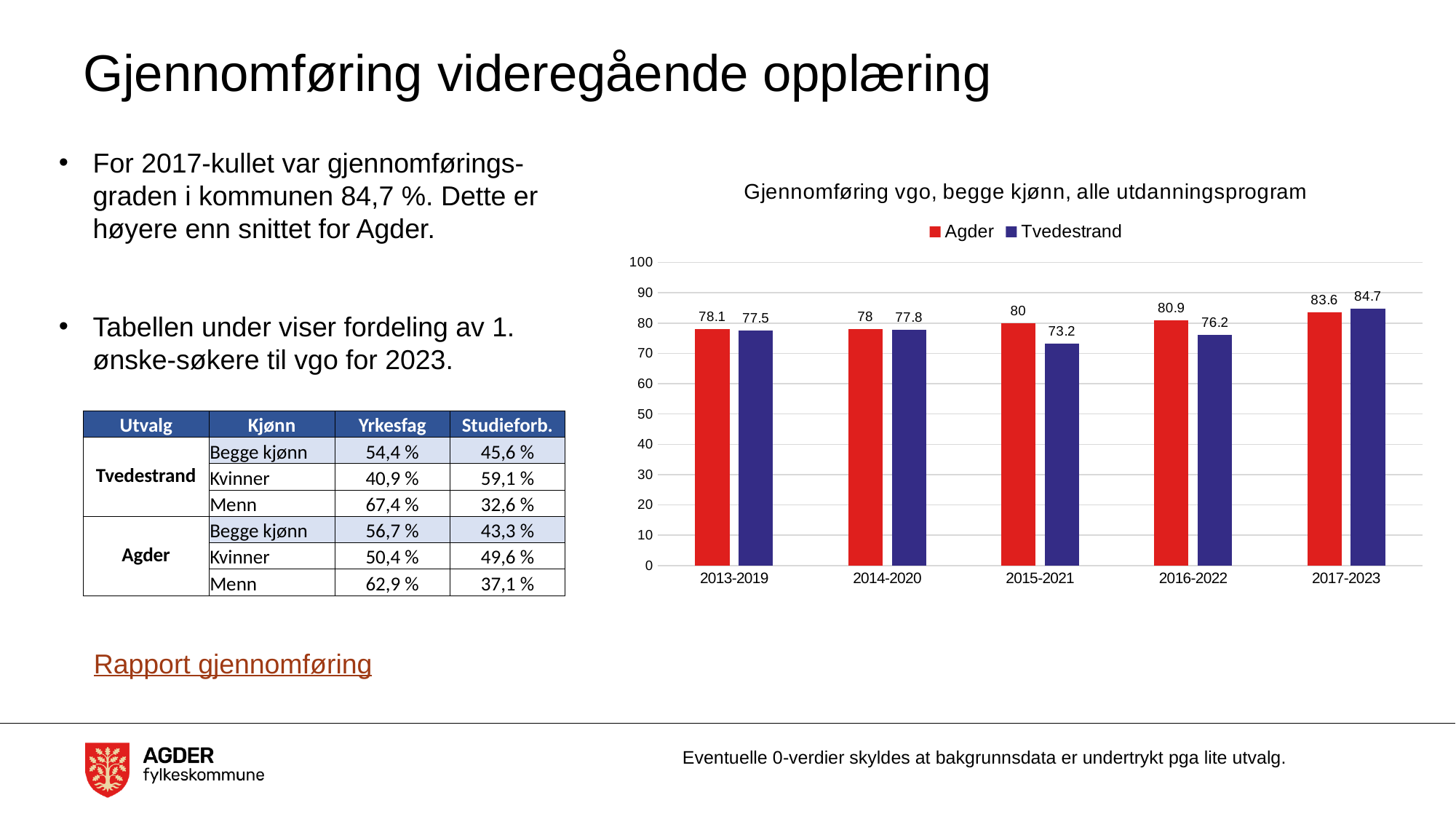
What is the title of the chart? Gjennomføring vgo, begge kjønn, alle utdanningsprogram Is the value for Tvedestrand in 2014-2020 greater or less than 70? greater Which period has the lowest value for Tvedestrand? 2015-2021 What is the value for Tvedestrand in 2015-2021? 73.2 What is the difference between Agder and Tvedestrand in 2015-2021? 6.8 What is the value for Agder in 2015-2021? 80 What kind of chart is shown? bar chart What is the value for Tvedestrand in 2017-2023? 84.7 Which period has the highest value for Agder? 2017-2023 How many periods are shown on the x axis? 5 Which is larger in 2016-2022, Agder or Tvedestrand? Agder How many series does the legend list? 2